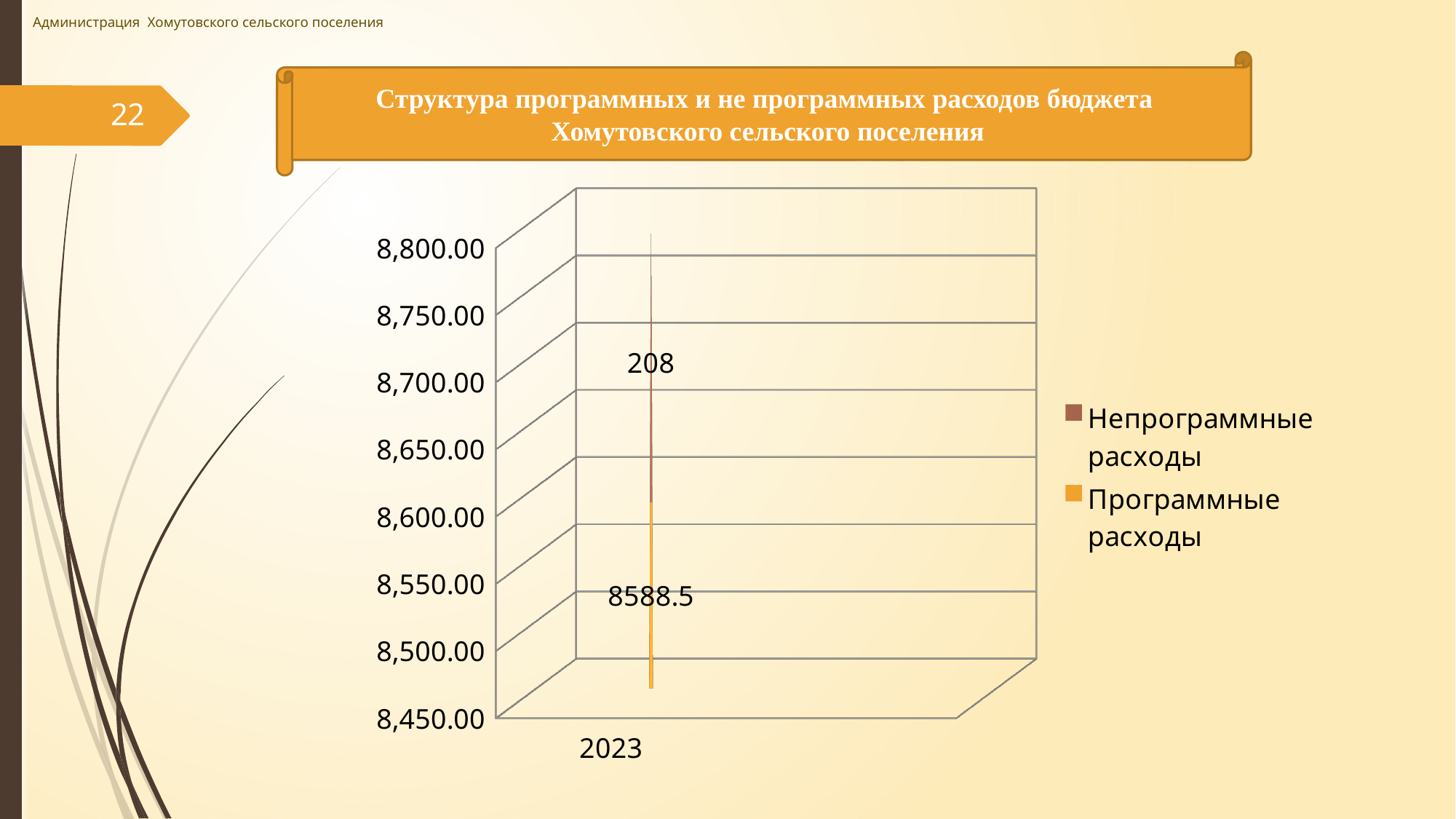
Which series has the larger value for 2023, Программные расходы or Непрограммные расходы? Программные расходы What is the value of Программные расходы for 2023? 8588.5 What is the total of the stacked bar for 2023? 8796.5 What kind of chart is shown on the slide? Stacked bar chart What is the difference between Программные расходы and Непрограммные расходы for 2023? 8380.5 What is the value of Непрограммные расходы for 2023? 208 What colour represents Программные расходы in the legend? Orange How many series does the legend list? 2 Which year is shown on the x axis of the chart? 2023 Which series has the smallest value for 2023? Непрограммные расходы How many categories are shown on the x axis? 1